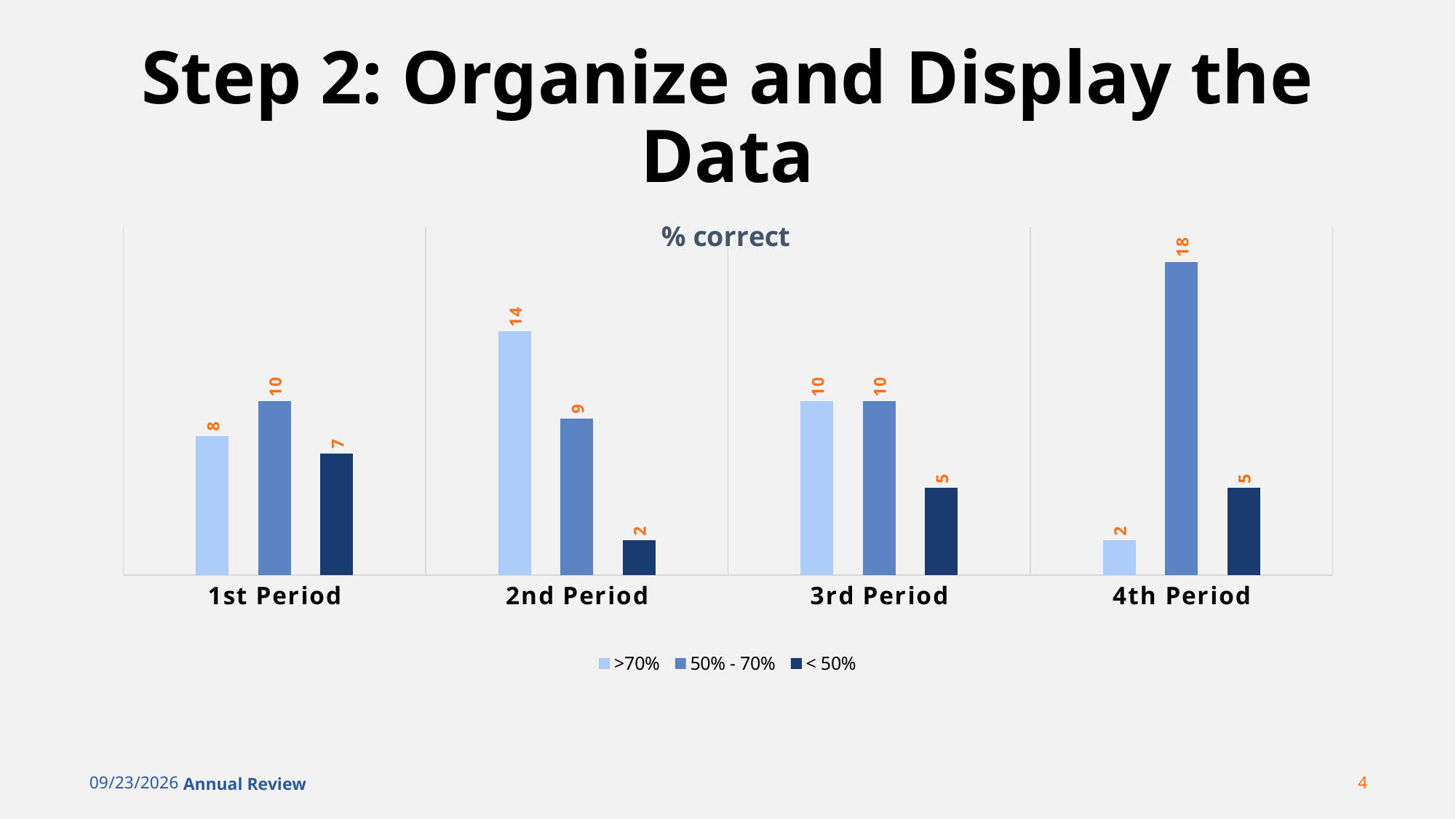
What is the total of the three values in 3rd Period? 25 What is the value for >70% in 2nd Period? 14 Which period has the lowest value for the >70% series? 4th Period How many periods are shown on the x axis? 4 What is the value for 50% - 70% in 4th Period? 18 How many series does the legend list? 3 Which period has the highest value for the 50% - 70% series? 4th Period What is the value for < 50% in 1st Period? 7 What is the difference between the >70% and < 50% values in 2nd Period? 12 What is the title of the chart? % correct Which is larger in 1st Period: the >70% value or the 50% - 70% value? 50% - 70% What kind of chart is shown on the slide? bar chart